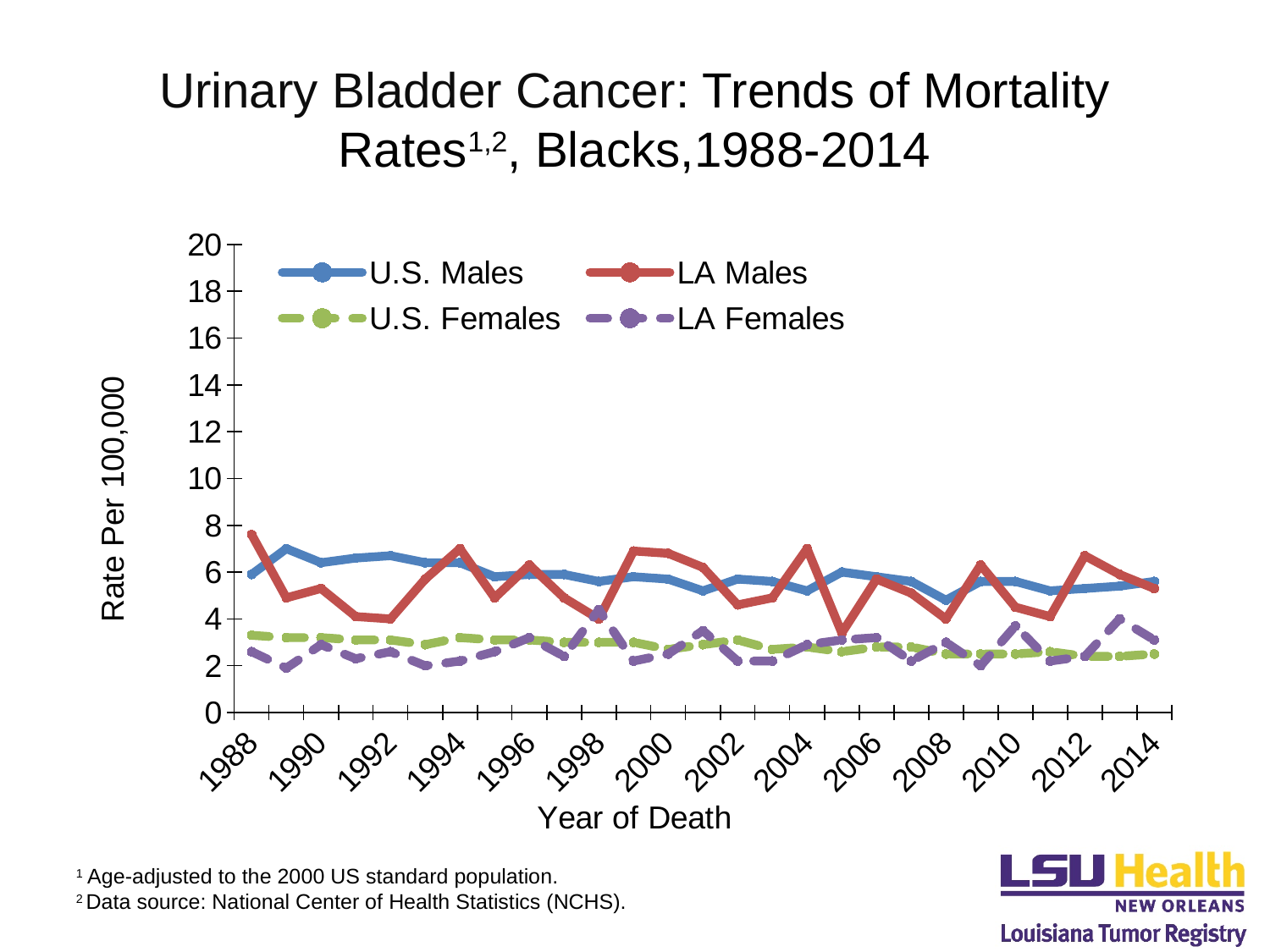
Is the value for LA Males in 1988 greater or less than 6? greater Does the U.S. Females line generally rise or fall from 1988 to 2014? fall Is the value for U.S. Males in 1989 greater or less than 6? greater Is the value for LA Males in 2005 greater or less than 6? less How many series does the legend list? 4 Which series has the highest value in 1988? LA Males How many years of data are plotted along the x axis (1988 through 2014)? 27 What kind of chart is shown on the slide? line chart In 2005, which is larger: U.S. Males or LA Males? U.S. Males What is the label on the y axis? Rate Per 100,000 In 1988, which is larger: LA Males or U.S. Males? LA Males